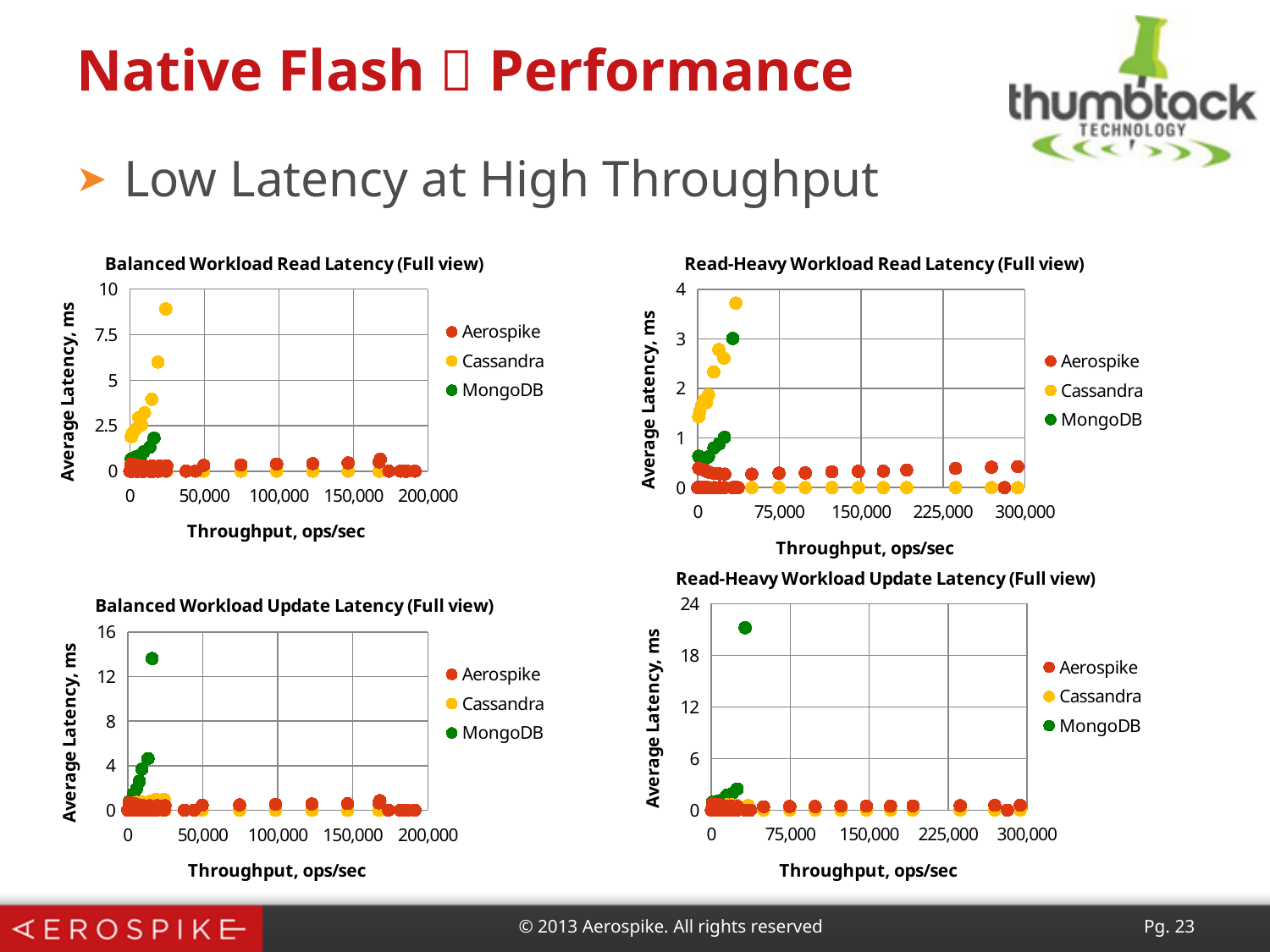
How many series does the legend of the "Read-Heavy Workload Read Latency (Full view)" chart list? 3 In the "Balanced Workload Read Latency (Full view)" chart, which series has the highest plotted point? Cassandra In the "Balanced Workload Update Latency (Full view)" chart, is the highest MongoDB point greater or less than 12? greater In the "Read-Heavy Workload Update Latency (Full view)" chart, is the highest MongoDB point greater or less than 18? greater In the "Balanced Workload Update Latency (Full view)" chart, which series has the highest plotted point? MongoDB In the "Balanced Workload Read Latency (Full view)" chart, is the highest Cassandra point greater or less than 7.5? greater Which series are listed in the legend of the "Balanced Workload Update Latency (Full view)" chart? Aerospike, Cassandra, MongoDB What kind of chart is the "Balanced Workload Read Latency (Full view)" chart? scatter chart How many charts are shown on the slide? 4 In the "Read-Heavy Workload Update Latency (Full view)" chart, which series has the highest plotted point? MongoDB What is the x-axis label of the "Read-Heavy Workload Read Latency (Full view)" chart? Throughput, ops/sec